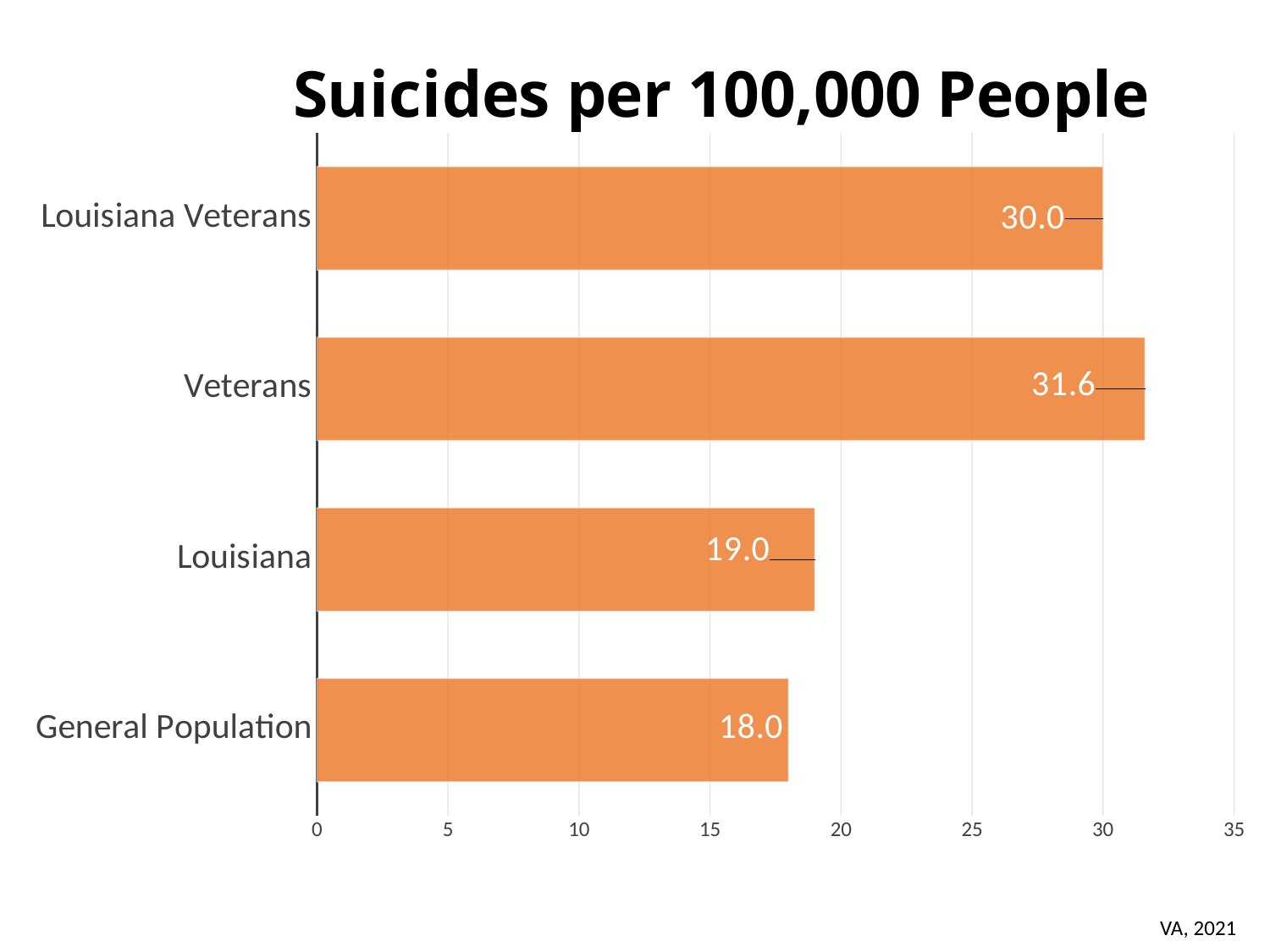
What is the value for Louisiana Veterans? 30.0 What is the value for General Population? 18.0 Which is larger, the value for Louisiana Veterans or the value for Louisiana? Louisiana Veterans What is the value for Louisiana? 19.0 Which category has the lowest value? General Population How many categories are shown in the chart? 4 What kind of chart is shown on the slide? Bar chart What is the difference between the values for Veterans and Louisiana Veterans? 1.6 What is the title of the chart? Suicides per 100,000 People Which category has the highest value? Veterans What is the value for Veterans? 31.6 What is the difference between the values for Louisiana and General Population? 1.0